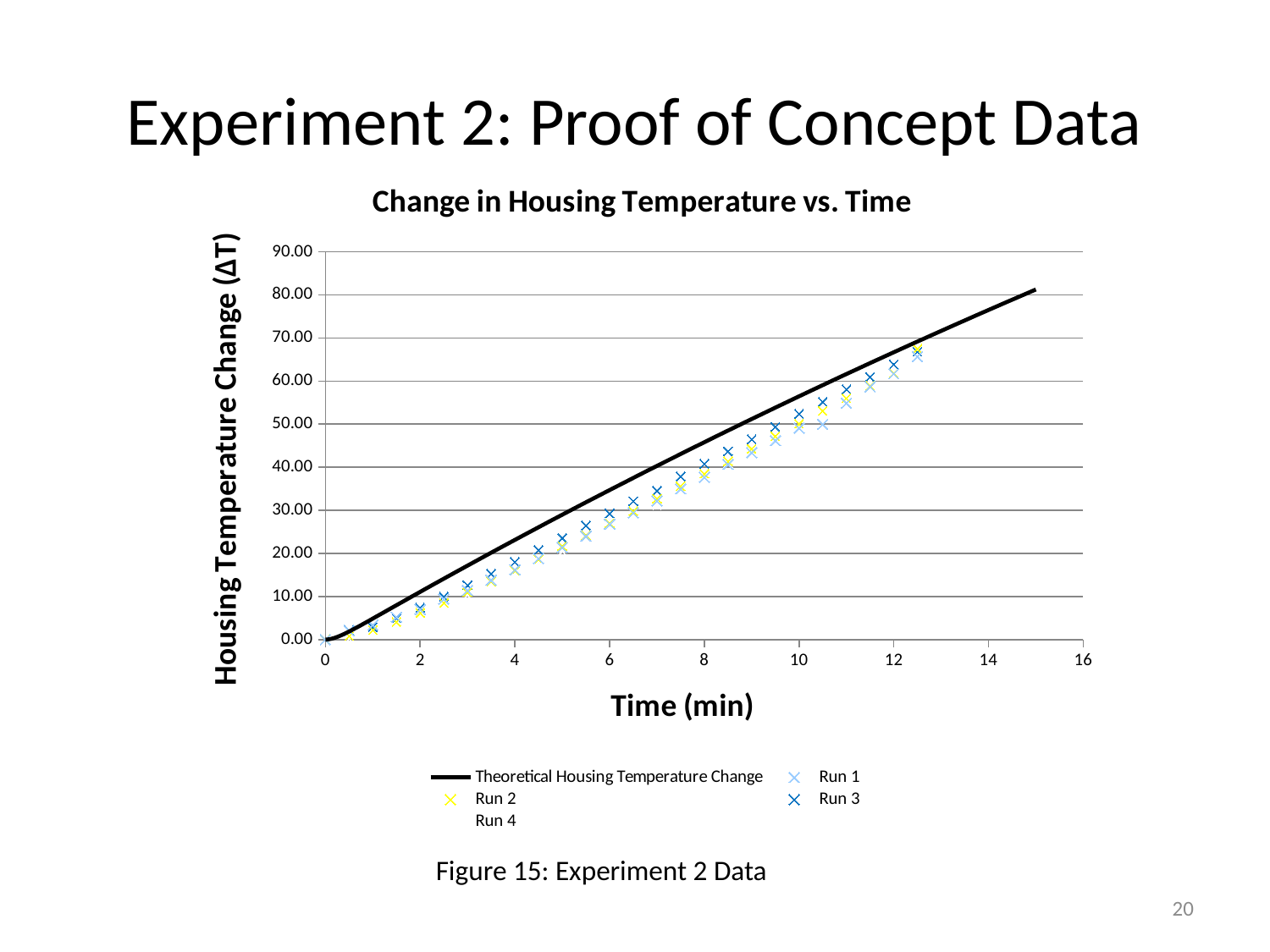
Is the value of the Theoretical Housing Temperature Change line at 8 minutes greater or less than 40? greater Do the plotted values rise or fall as time increases? rise What is the title of the chart? Change in Housing Temperature vs. Time What is the highest value shown on the y axis? 90.00 What is the label of the x axis? Time (min) How many series does the chart legend list? 5 At 10 minutes, which is higher: the Theoretical Housing Temperature Change line or the Run 1 data points? Theoretical Housing Temperature Change How many experimental runs are plotted on the chart? 4 Are the experimental run values at 2 minutes greater or less than 10? less Is the value of the Theoretical Housing Temperature Change line at 10 minutes greater or less than 50? greater